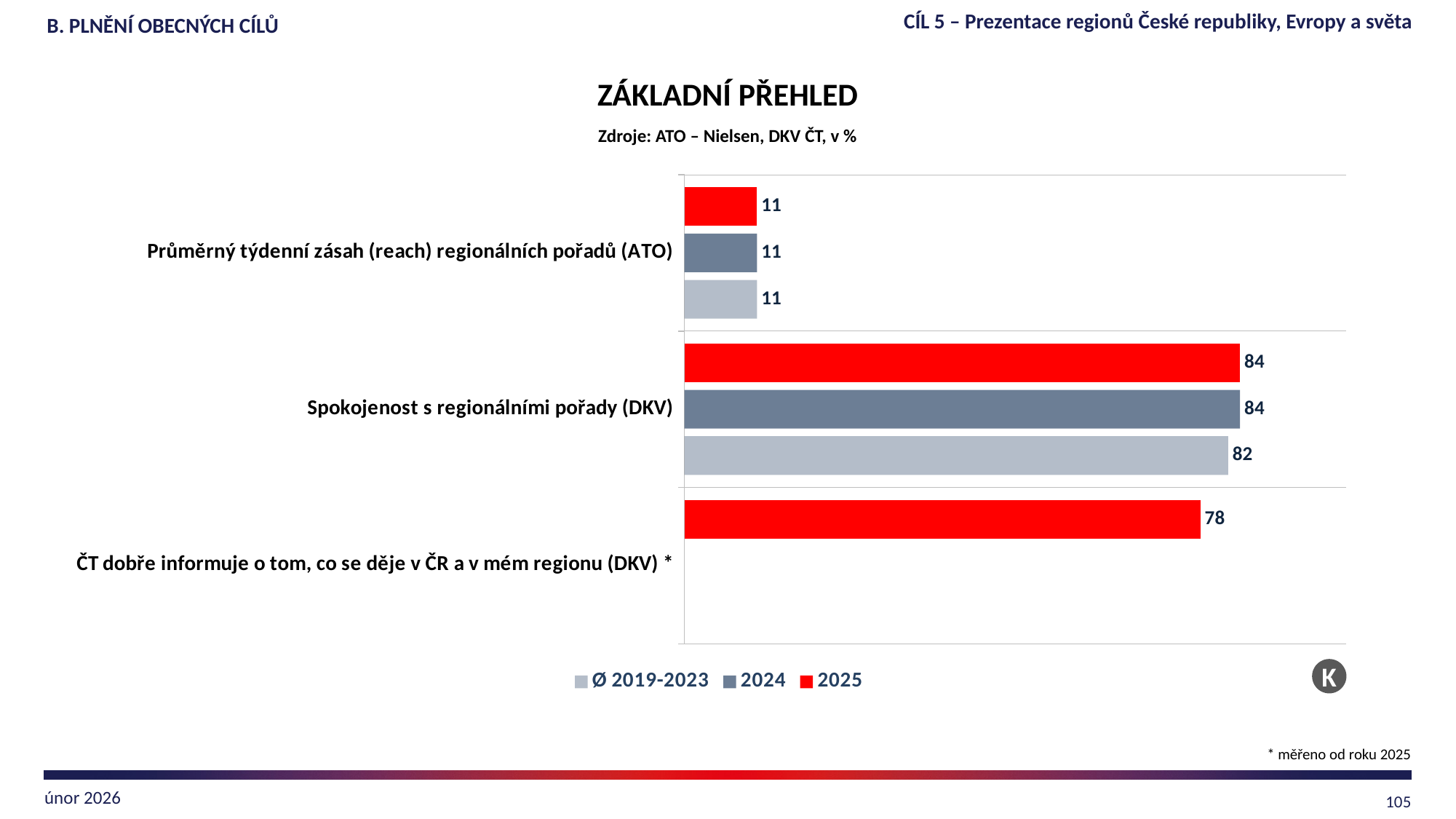
Which is larger: the 2025 value for "Spokojenost s regionálními pořady (DKV)" or the 2025 value for "ČT dobře informuje o tom, co se děje v ČR a v mém regionu (DKV)"? Spokojenost s regionálními pořady (DKV) How many categories are shown on the chart? 3 How many series does the legend list? 3 Which category has the highest 2025 value? Spokojenost s regionálními pořady (DKV) What kind of chart is shown on the slide? Bar chart Which series is shown in red in the legend? 2025 Which category has the lowest 2025 value? Průměrný týdenní zásah (reach) regionálních pořadů (ATO) What is the difference between the 2025 value and the Ø 2019-2023 value for "Spokojenost s regionálními pořady (DKV)"? 2 What is the 2024 value for "Průměrný týdenní zásah (reach) regionálních pořadů (ATO)"? 11 What is the Ø 2019-2023 value for "Spokojenost s regionálními pořady (DKV)"? 82 What is the 2025 value for "ČT dobře informuje o tom, co se děje v ČR a v mém regionu (DKV)"? 78 What is the 2025 value for "Spokojenost s regionálními pořady (DKV)"? 84